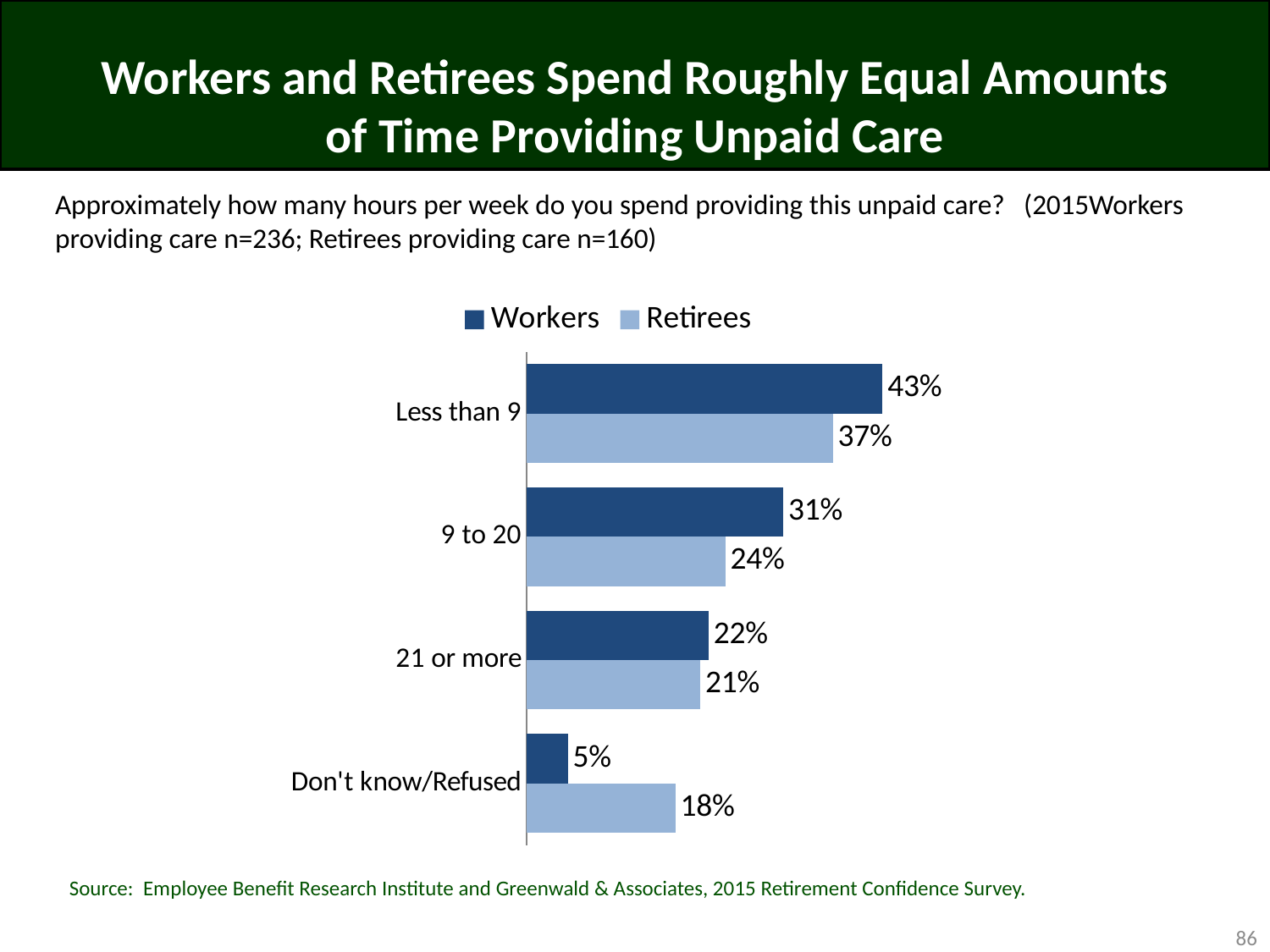
What is the value for Retirees in the Don't know/Refused category? 18% Which category has the highest value for Workers? Less than 9 Which series is shown in the darker blue colour? Workers How many series does the legend list? 2 What percentage of Workers spend less than 9 hours per week providing unpaid care? 43% What percentage of Retirees spend 9 to 20 hours per week providing unpaid care? 24% How many categories are shown on the chart? 4 What is the difference between the Workers and Retirees values for the 9 to 20 category? 7 percentage points In the Don't know/Refused category, which series has the larger value, Workers or Retirees? Retirees What kind of chart is shown on the slide? Bar chart Which category has the lowest value for Workers? Don't know/Refused What is the difference between the Retirees and Workers values in the Don't know/Refused category? 13 percentage points